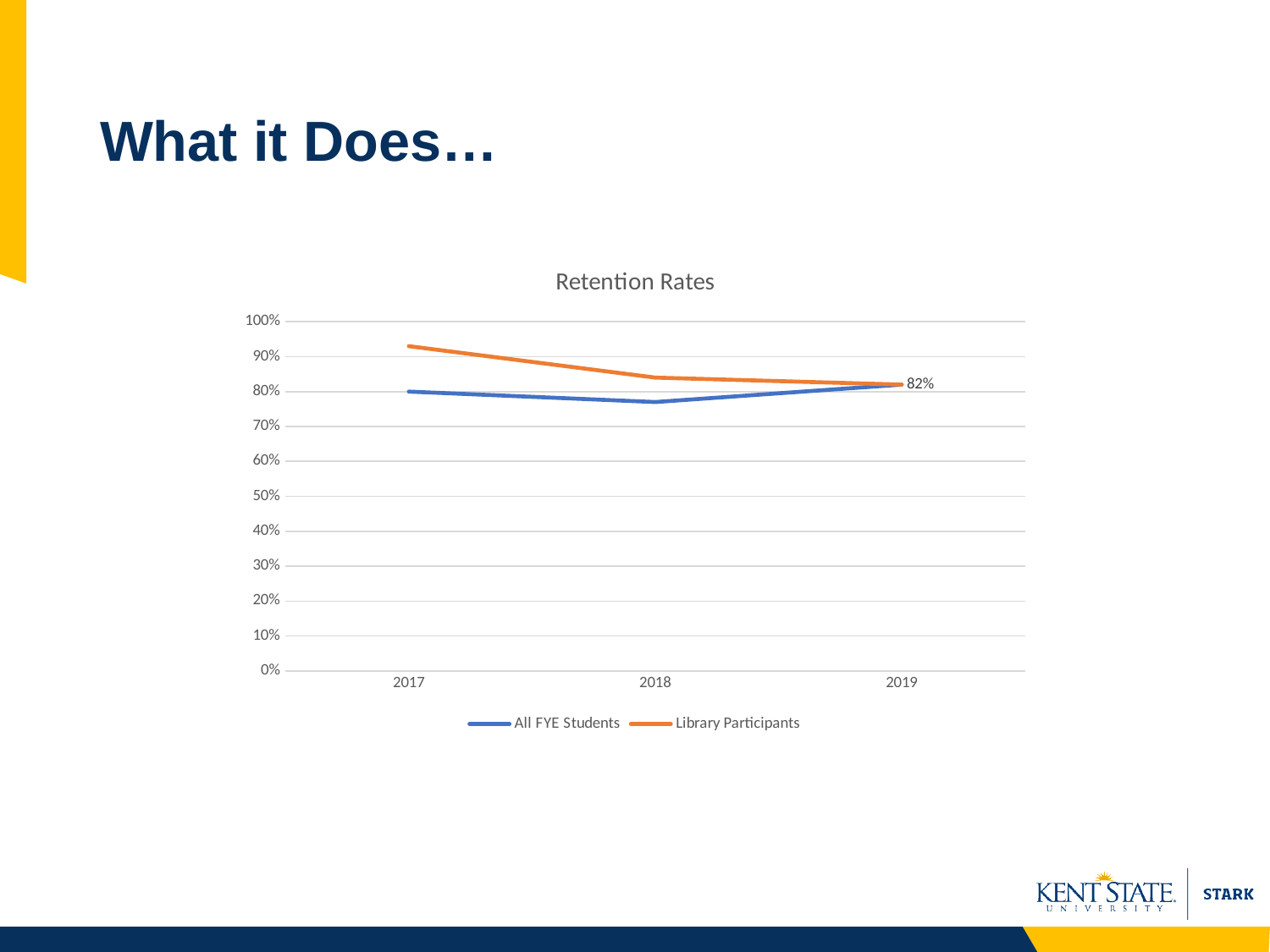
What type of chart is shown on the slide? line chart In which year is the Library Participants retention rate highest? 2017 How many series does the legend list? 2 Is the value for Library Participants in 2017 greater or less than 90%? greater What is the title of the chart? Retention Rates What data label is printed at the 2019 point? 82% Which series is drawn in orange? Library Participants How many years are plotted along the x axis? 3 Is the value for All FYE Students in 2018 greater or less than 80%? less Is the value for Library Participants in 2018 greater or less than 90%? less Does the Library Participants line rise or fall from 2017 to 2019? fall In 2017, which series has the higher retention rate, All FYE Students or Library Participants? Library Participants